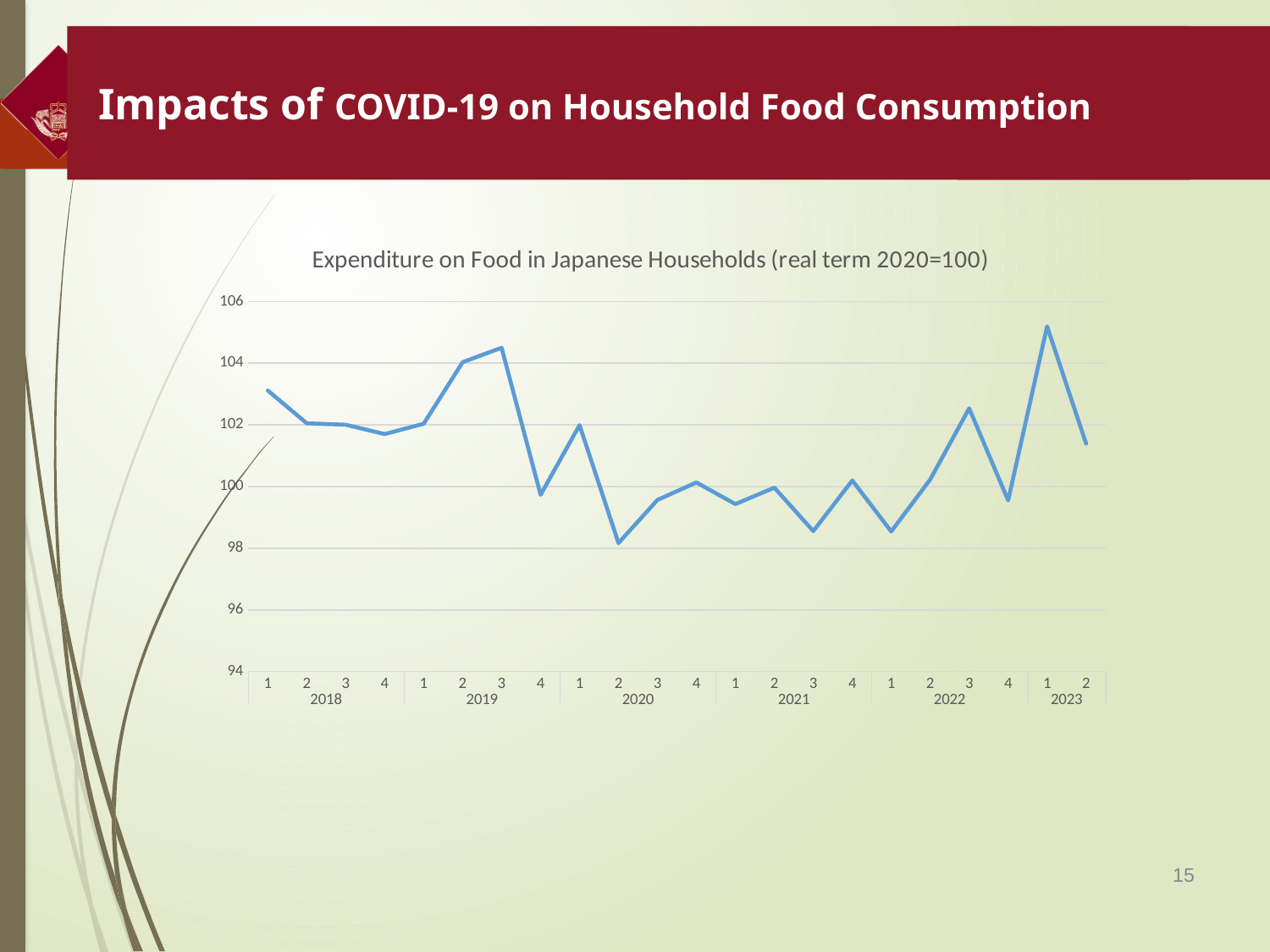
Is the value for Q3 2022 greater or less than 102? greater Is the value for Q3 2019 greater or less than 104? greater Does the value rise or fall from Q1 2018 to Q4 2018? fall Which is larger, the value for Q1 2023 or the value for Q2 2023? Q1 2023 What type of chart is shown on the slide? line chart Which quarter has the highest value on the chart? Q1 2023 What is the title of the chart? Expenditure on Food in Japanese Households (real term 2020=100) Is the value for Q2 2020 greater or less than 100? less Which is larger, the value for Q3 2019 or the value for Q2 2020? Q3 2019 How many quarterly data points are plotted on the chart? 22